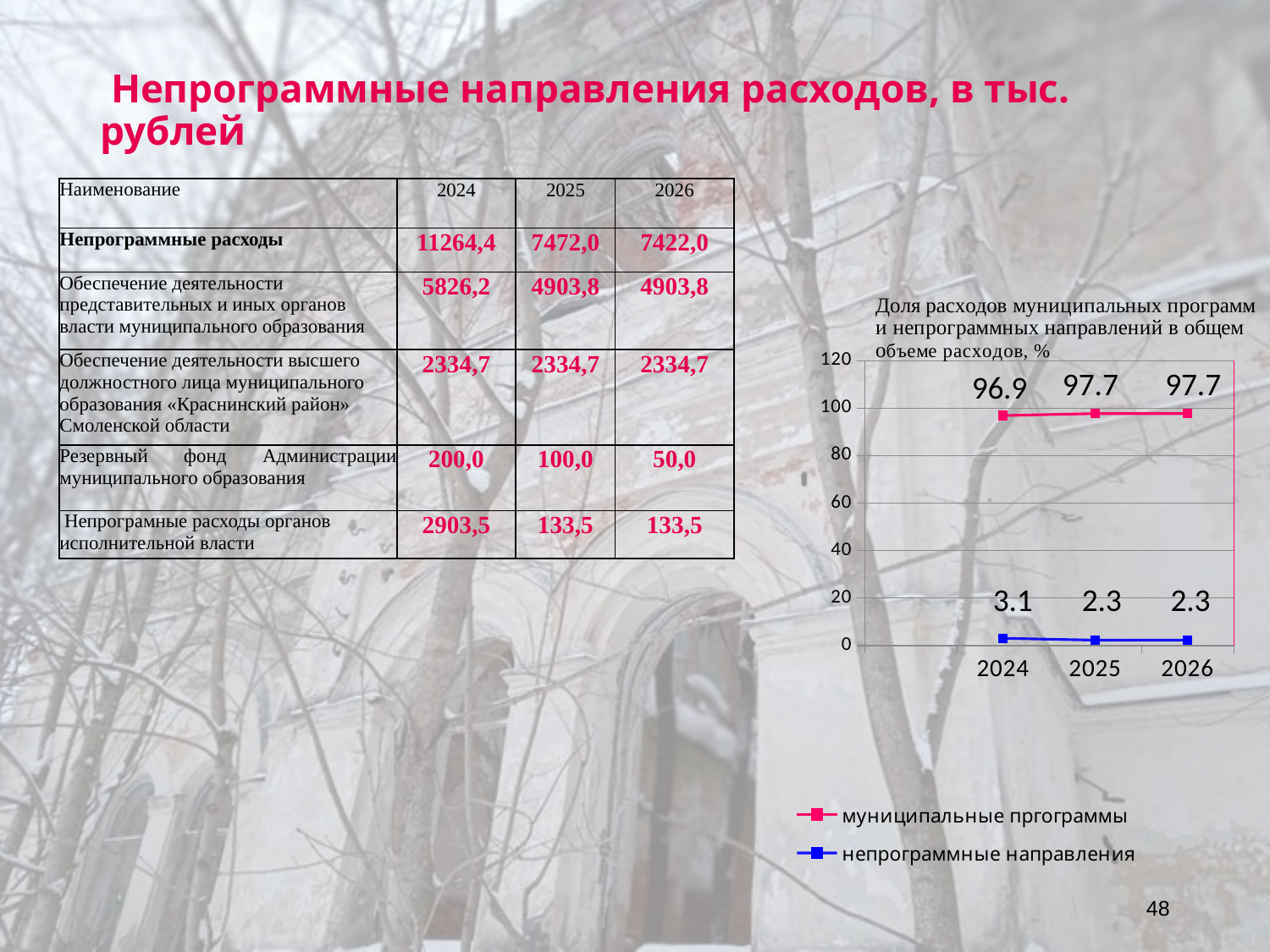
What is the value for муниципальные программы in 2024? 96.9 What is the value for непрограммные направления in 2025? 2.3 What is the difference between муниципальные программы and непрограммные направления in 2024? 93.8 In which year is the value for непрограммные направления highest? 2024 How many years are shown on the x axis of the chart? 3 What is the value for муниципальные программы in 2026? 97.7 What type of chart is shown on the slide? line chart What is the value for непрограммные направления in 2024? 3.1 In which year is the value for муниципальные программы lowest? 2024 How many series does the chart legend list? 2 Does the value for непрограммные направления rise or fall from 2024 to 2025? fall Which is larger in 2025: муниципальные программы or непрограммные направления? муниципальные программы